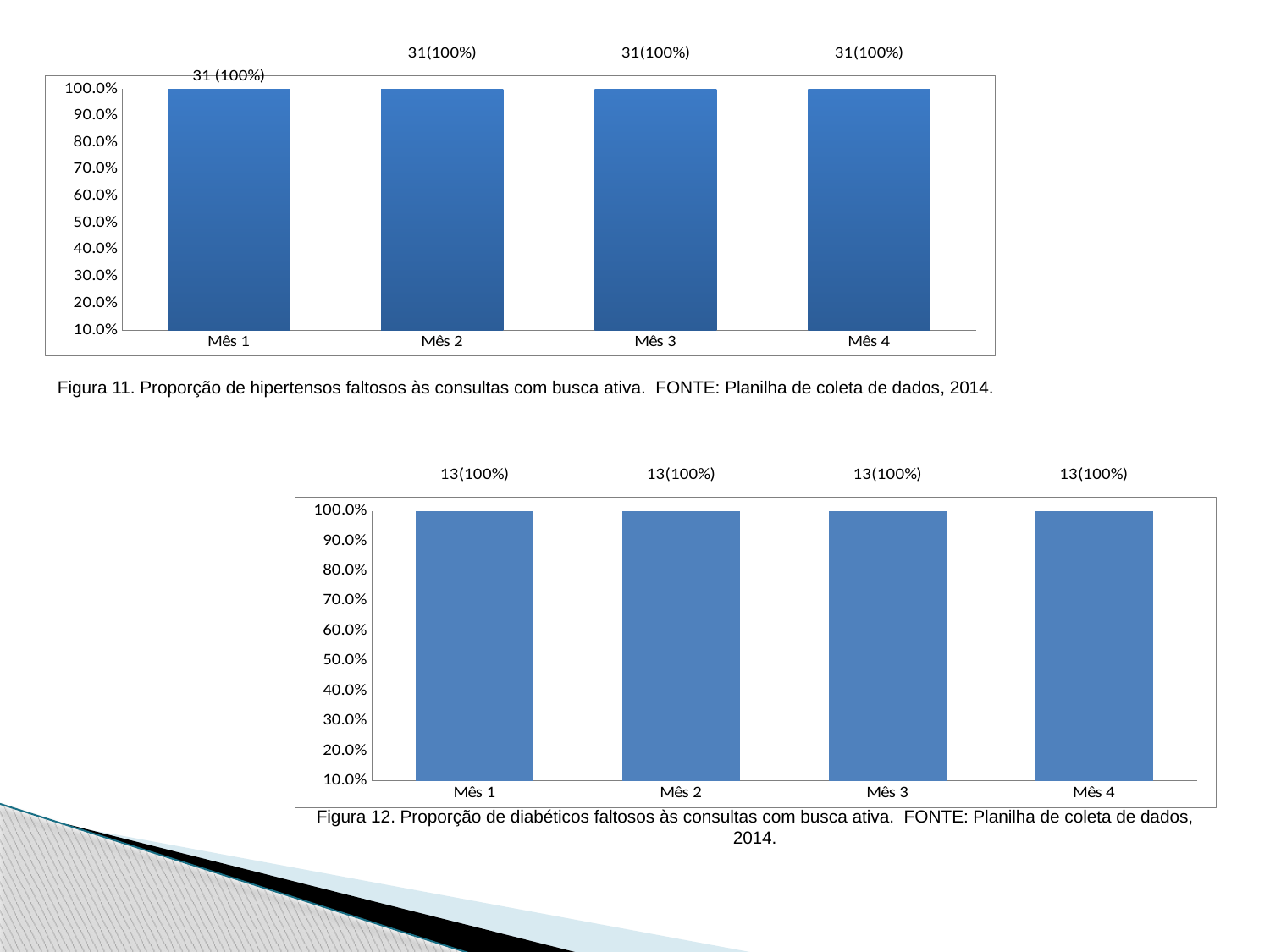
In the top chart (Figura 11), what is the data label shown for Mês 3? 31(100%) In the top chart (Figura 11), what is the difference between the percentage for Mês 1 and Mês 4? 0% In the bottom chart (Figura 12), what is the data label shown for Mês 2? 13(100%) How many bars are plotted in the top chart (Figura 11)? 4 According to its caption, what does the bottom chart (Figura 12) show the proportion of? Diabéticos faltosos às consultas com busca ativa What kind of chart is the bottom chart (Figura 12)? Bar chart In the bottom chart (Figura 12), what is the data label shown for Mês 4? 13(100%) In the top chart (Figura 11), what is the data label shown for Mês 1? 31 (100%) In the bottom chart (Figura 12), do the values rise, fall, or stay the same across the months? Stay the same What kind of chart is the top chart (Figura 11)? Bar chart In the top chart (Figura 11), do the values rise, fall, or stay the same from Mês 1 to Mês 4? Stay the same How many categories are shown on the x axis of the bottom chart (Figura 12)? 4